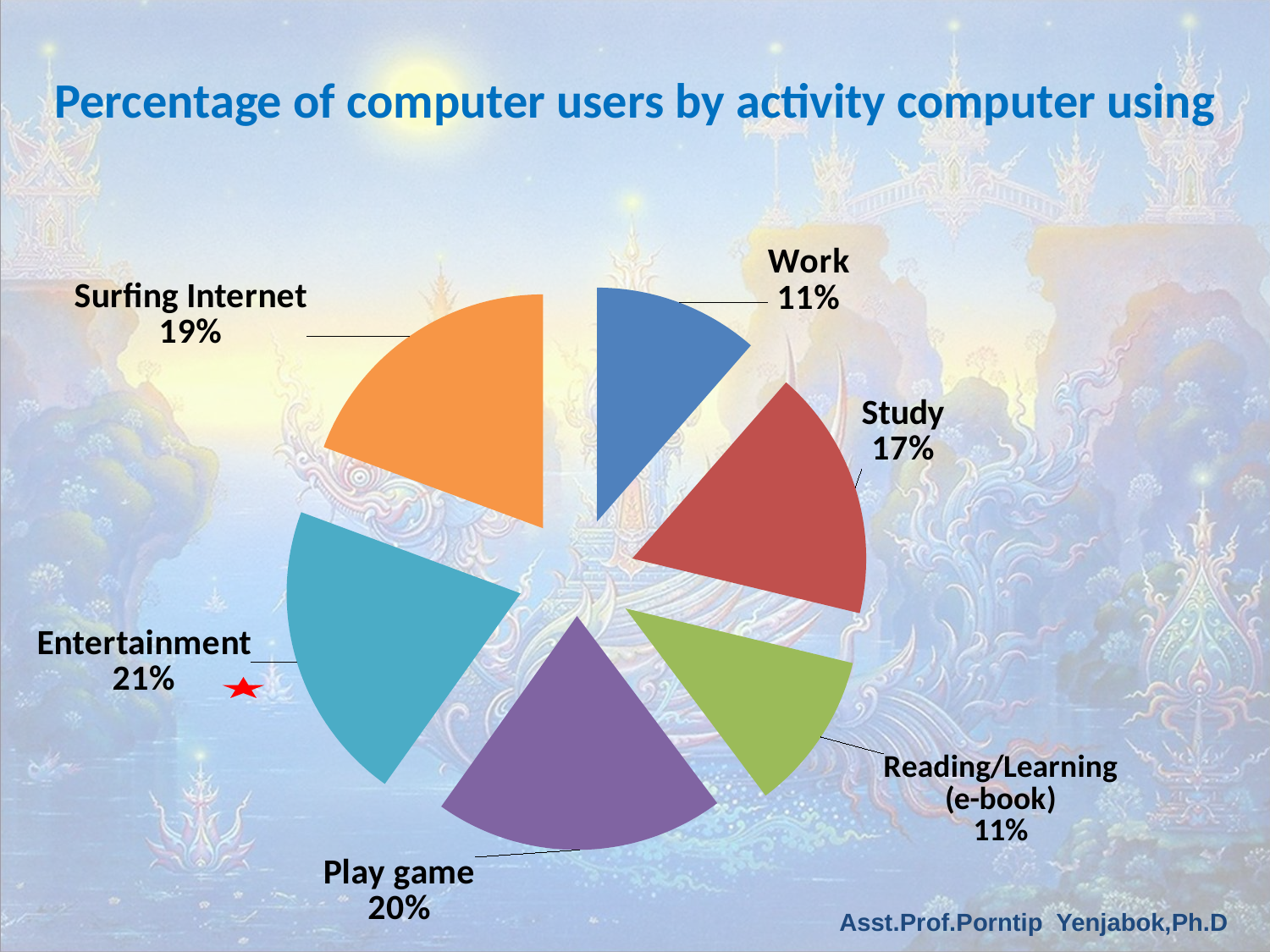
What percentage of computer users is shown for Entertainment? 21% What percentage of computer users is shown for Play game? 20% What percentage of computer users is shown for Study? 17% What is the title of the chart? Percentage of computer users by activity computer using What kind of chart is shown on the slide? pie chart Which is larger, the share for Study or the share for Surfing Internet? Surfing Internet Which activity has the largest share of the pie? Entertainment What is the difference between the Entertainment share and the Work share? 10% What percentage of computer users is shown for Surfing Internet? 19% How many slices does the pie chart have? 6 What colour is the Play game slice? purple What is the difference between the Play game share and the Study share? 3%